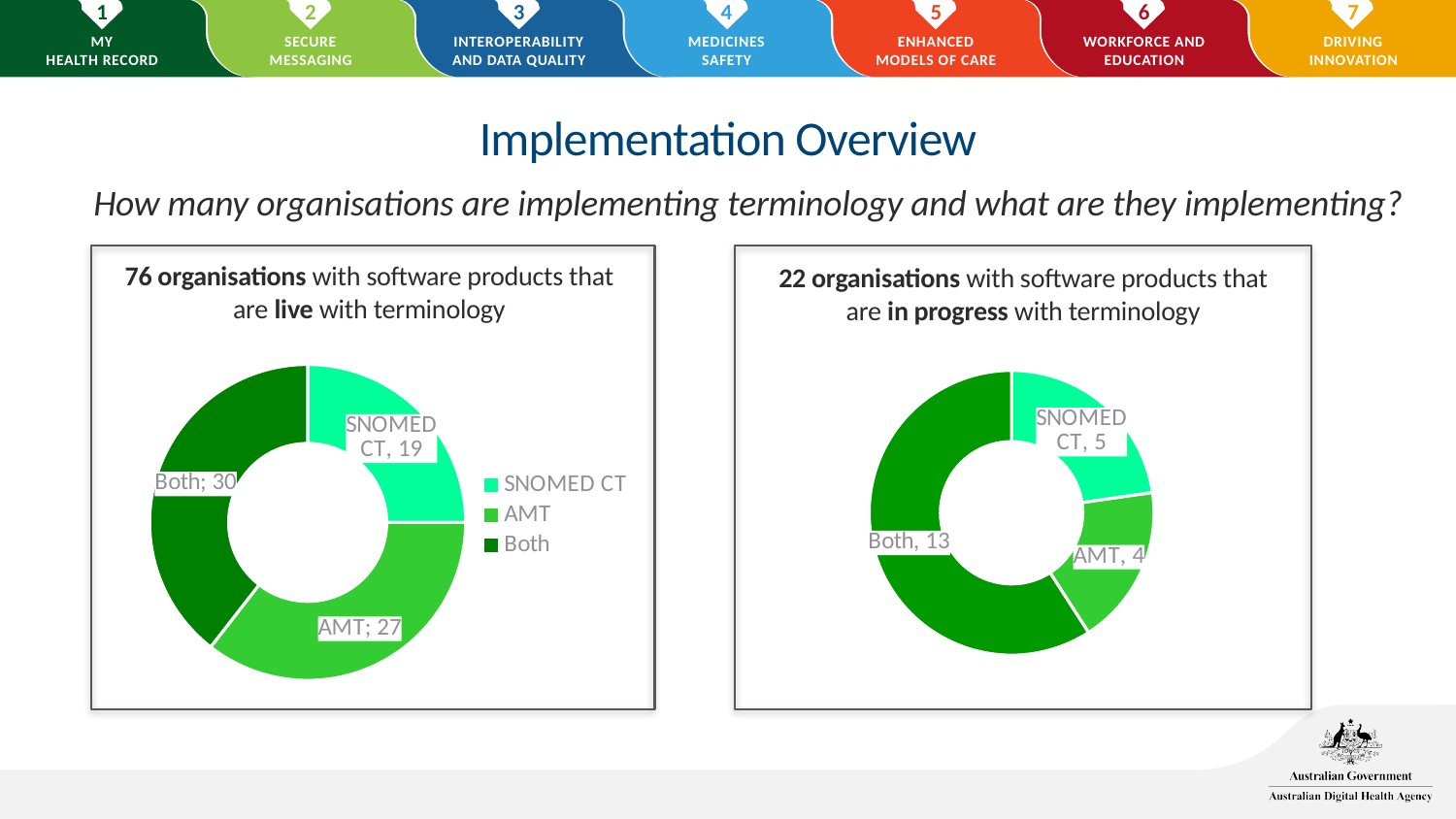
In the left chart (organisations live with terminology), how many organisations are implementing Both? 30 In the left chart (organisations live with terminology), which category has the lowest value? SNOMED CT In the right chart (organisations in progress with terminology), what is the difference between Both and AMT? 9 In the right chart (organisations in progress with terminology), what is the value for SNOMED CT? 5 In the right chart (organisations in progress with terminology), which is larger, SNOMED CT or AMT? SNOMED CT In the left chart (organisations live with terminology), what is the difference between Both and SNOMED CT? 11 In the left chart (organisations live with terminology), what share of the 76 organisations are implementing SNOMED CT only? 25% In the left chart (organisations live with terminology), what is the value for AMT? 27 What kind of chart is used on the left of the slide? doughnut chart How many entries does the legend of the left chart list? 3 How many categories does the left chart (organisations live with terminology) show? 3 In the right chart (organisations in progress with terminology), which category has the highest value? Both